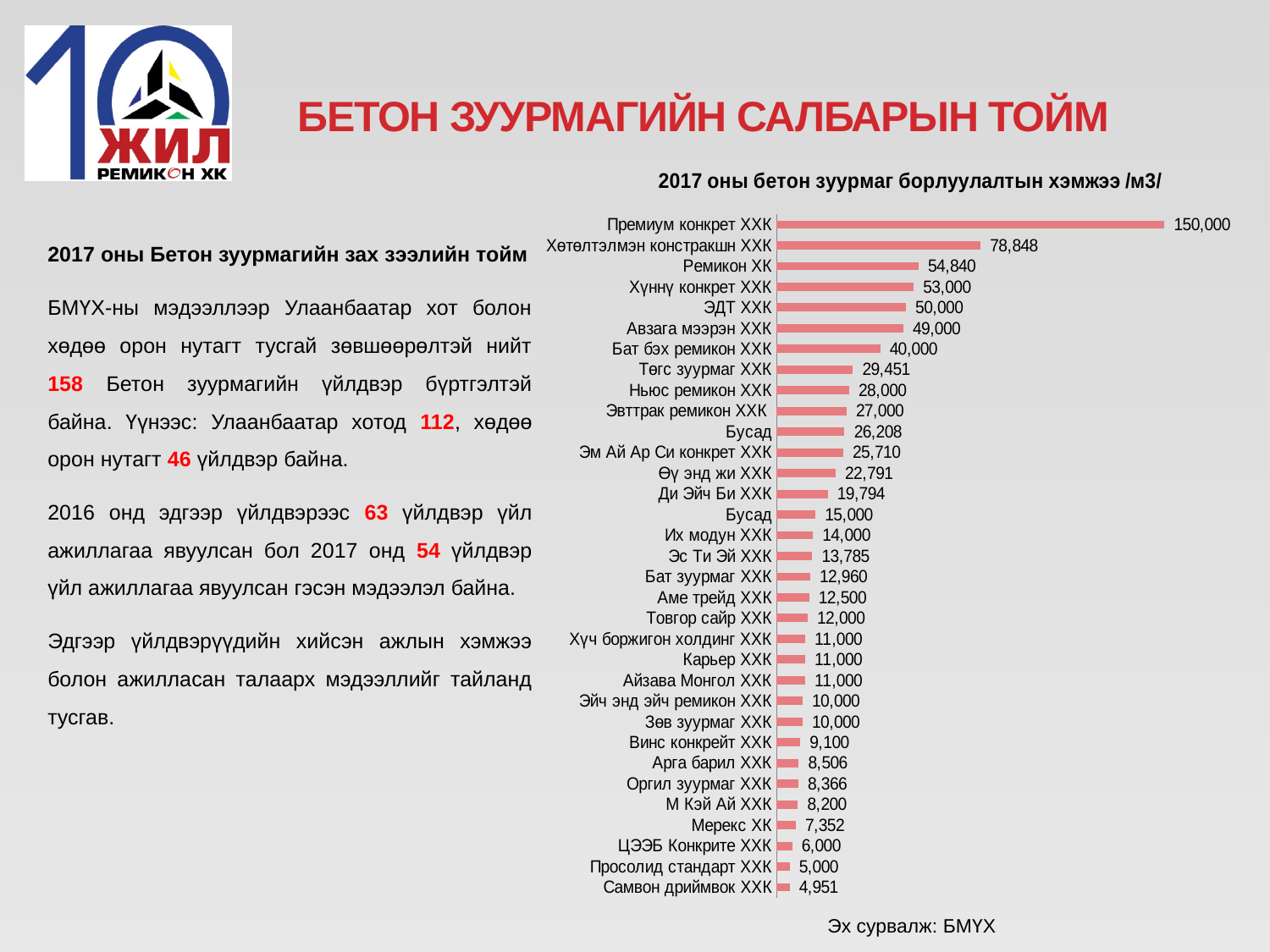
Which company has the highest value in the chart? Премиум конкрет ХХК What is the difference between the values for Премиум конкрет ХХК and Хөтөлтэлмэн констракшн ХХК? 71,152 What type of chart is shown on the slide? bar chart Which company has the lowest value in the chart? Самвон дриймвок ХХК What is the title of the chart? 2017 оны бетон зуурмаг борлуулалтын хэмжээ /м3/ What is the value for Премиум конкрет ХХК? 150,000 Which is larger, the value for Хүннү конкрет ХХК or the value for ЭДТ ХХК? Хүннү конкрет ХХК What is the difference between the values for Ньюс ремикон ХХК and Эвттрак ремикон ХХК? 1,000 How many bars are plotted in the chart? 33 What is the value for Мерекс ХК? 7,352 What is the value for Төгс зуурмаг ХХК? 29,451 What is the value for Ремикон ХК? 54,840